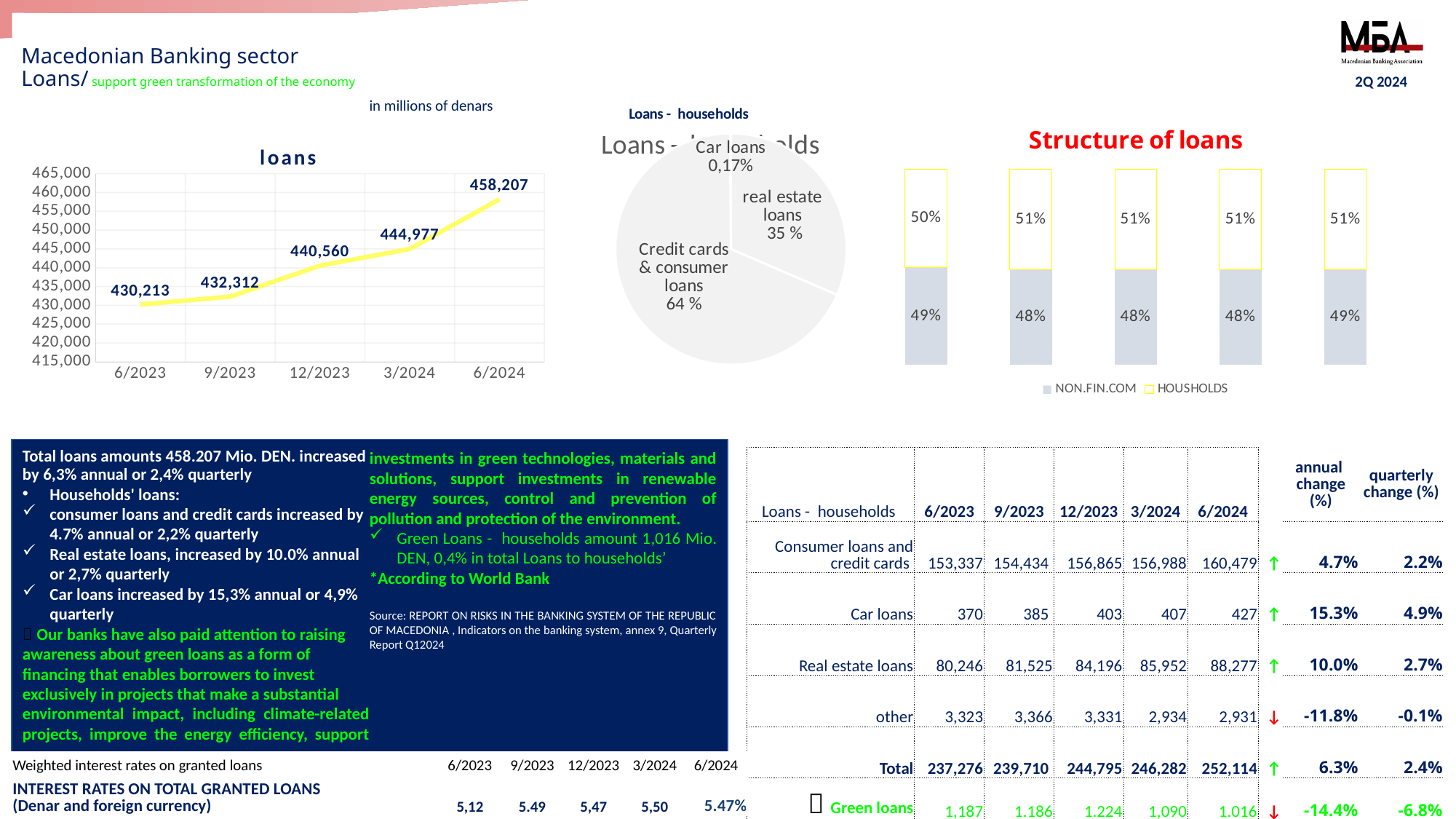
In the "loans" line chart, what is the value for 12/2023? 440,560 In the "loans" line chart, what is the difference between the 6/2024 value and the 6/2023 value? 27,994 In the "loans" line chart, which period has the lowest value? 6/2023 In the "loans" line chart, do the values rise or fall from 6/2023 to 6/2024? rise In the "Loans - households" pie chart, what share do Car loans have? 0,17% How many series does the legend of the "Structure of loans" chart list? 2 What kind of chart is the "loans" chart? line chart In the "Structure of loans" chart, what is the NON.FIN.COM value in the first (leftmost) bar? 49% How many data points are plotted in the "loans" line chart? 5 In the "Loans - households" pie chart, what share do Credit cards & consumer loans have? 64 % In the "Loans - households" pie chart, which slice is the largest? Credit cards & consumer loans In the "loans" line chart, what is the value for 6/2024? 458,207